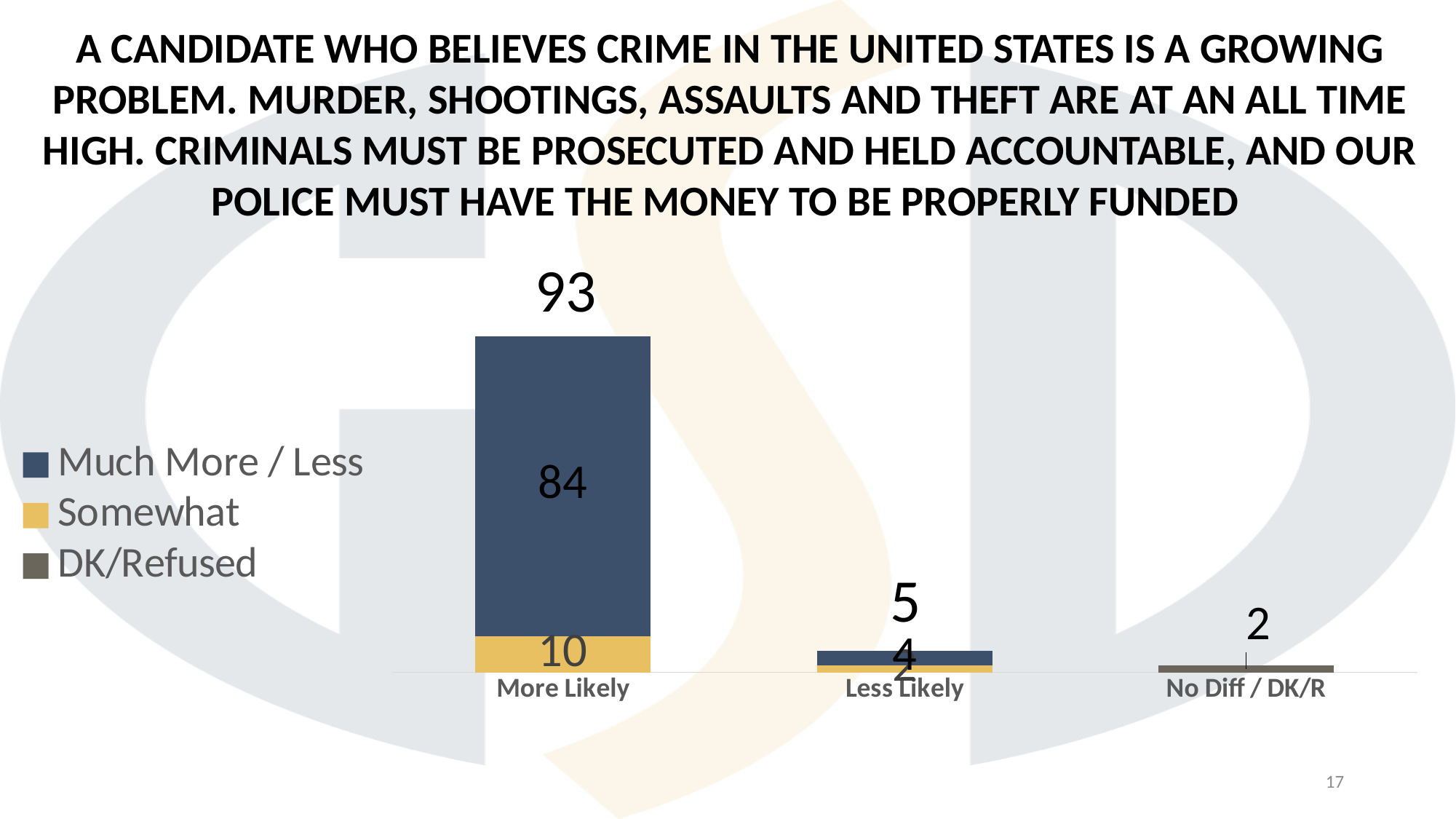
What is the value printed above the No Diff / DK/R bar? 2 What is the difference between the More Likely total and the Less Likely total? 88 What total is printed above the More Likely bar? 93 How many categories are shown on the x axis? 3 What total is printed above the Less Likely bar? 5 What is the Much More / Less value for the Less Likely bar? 4 Which category has the highest total? More Likely What is the Somewhat value for the More Likely bar? 10 Which category has the lowest total? No Diff / DK/R What is the Much More / Less value for the More Likely bar? 84 How many series does the legend list? 3 Which is larger, the Less Likely total or the No Diff / DK/R value? Less Likely